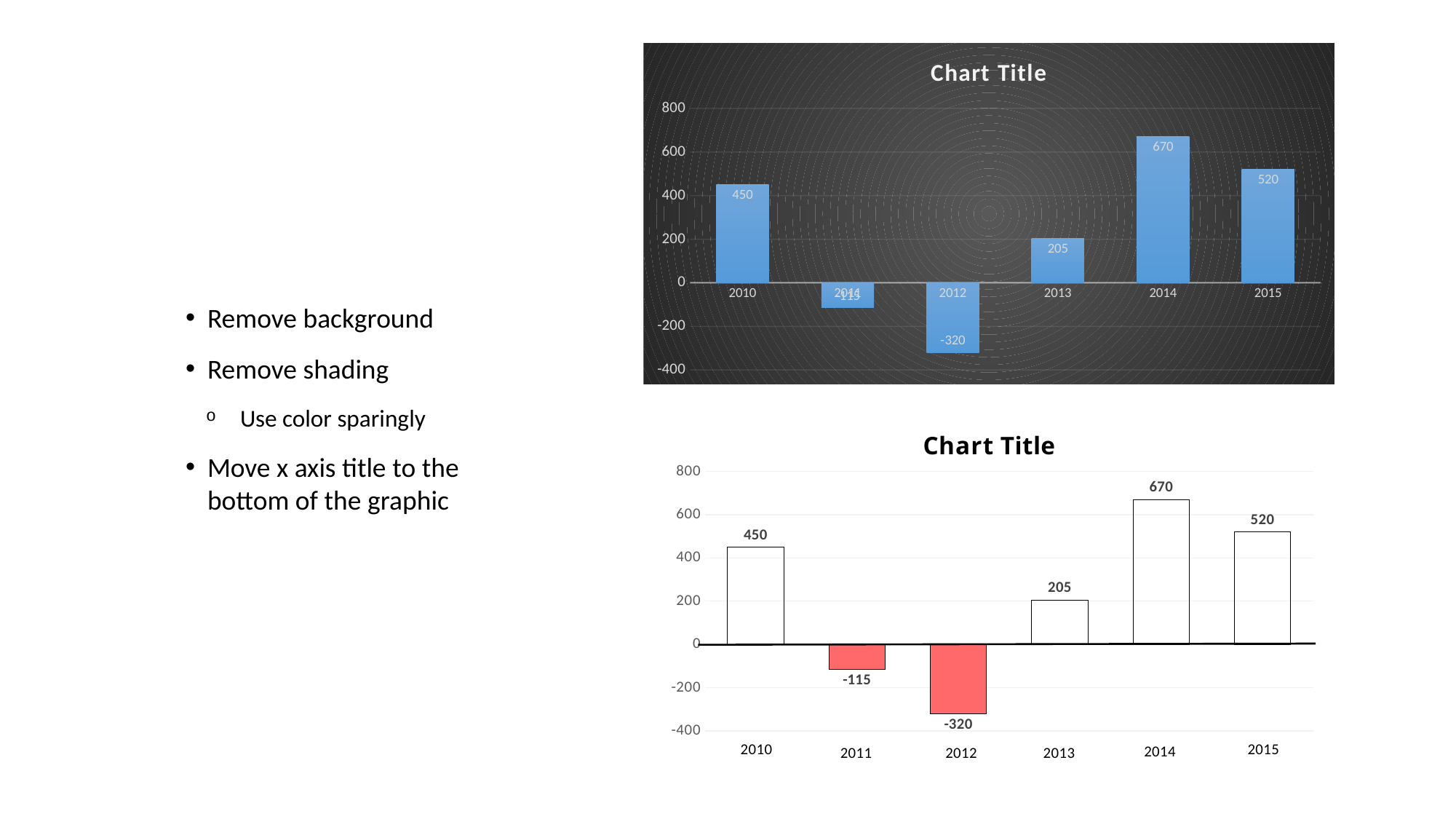
In the bottom chart, what is the value for 2011? -115 In the top chart, what is the value for 2010? 450 In the bottom chart, what is the difference between the values for 2014 and 2015? 150 In the bottom chart, what is the value for 2014? 670 In the bottom chart, which year has the highest value? 2014 In the bottom chart, what is the value for 2012? -320 In the top chart, which is larger, the value for 2013 or the value for 2015? 2015 In the bottom chart, which year has the lowest value? 2012 How many years are shown on the x axis of the bottom chart? 6 In the bottom chart, what colour are the bars with negative values? red What kind of chart is the bottom chart? bar chart In the bottom chart, how many years have negative values? 2